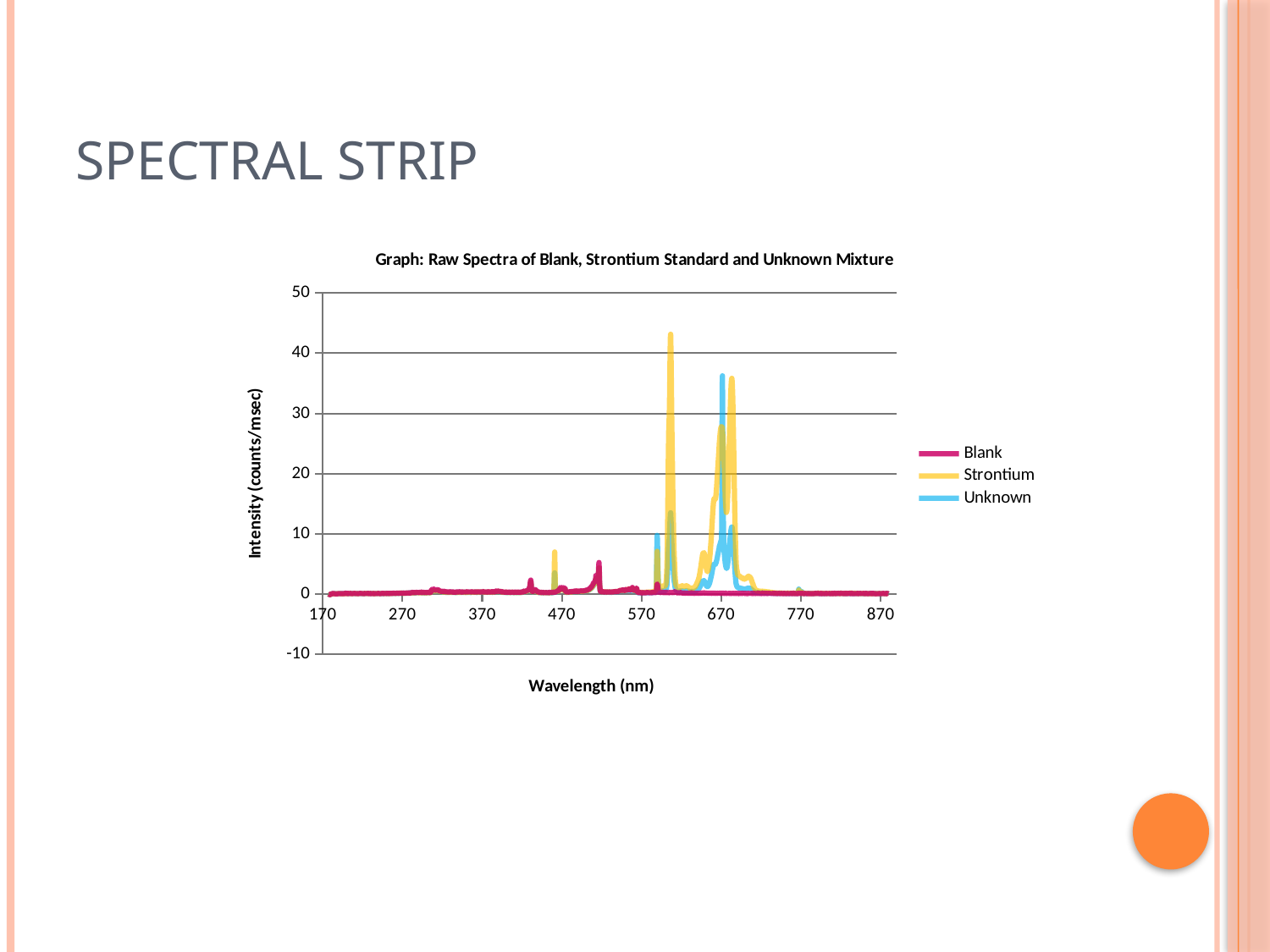
Is the highest peak of the Strontium series greater or less than 40 counts/msec? greater Is the highest peak of the Blank series greater or less than 10 counts/msec? less Which series has the lowest maximum intensity on the chart? Blank Which series has a higher maximum peak, Blank or Unknown? Unknown Which series has a higher maximum peak, Strontium or Unknown? Strontium How many series does the legend list? 3 Is the highest peak of the Unknown series greater or less than 40 counts/msec? less Which series reaches the highest peak intensity on the chart? Strontium What is the title of the chart? Graph: Raw Spectra of Blank, Strontium Standard and Unknown Mixture What kind of chart is shown on the slide? Line chart What is the label of the vertical axis? Intensity (counts/msec)